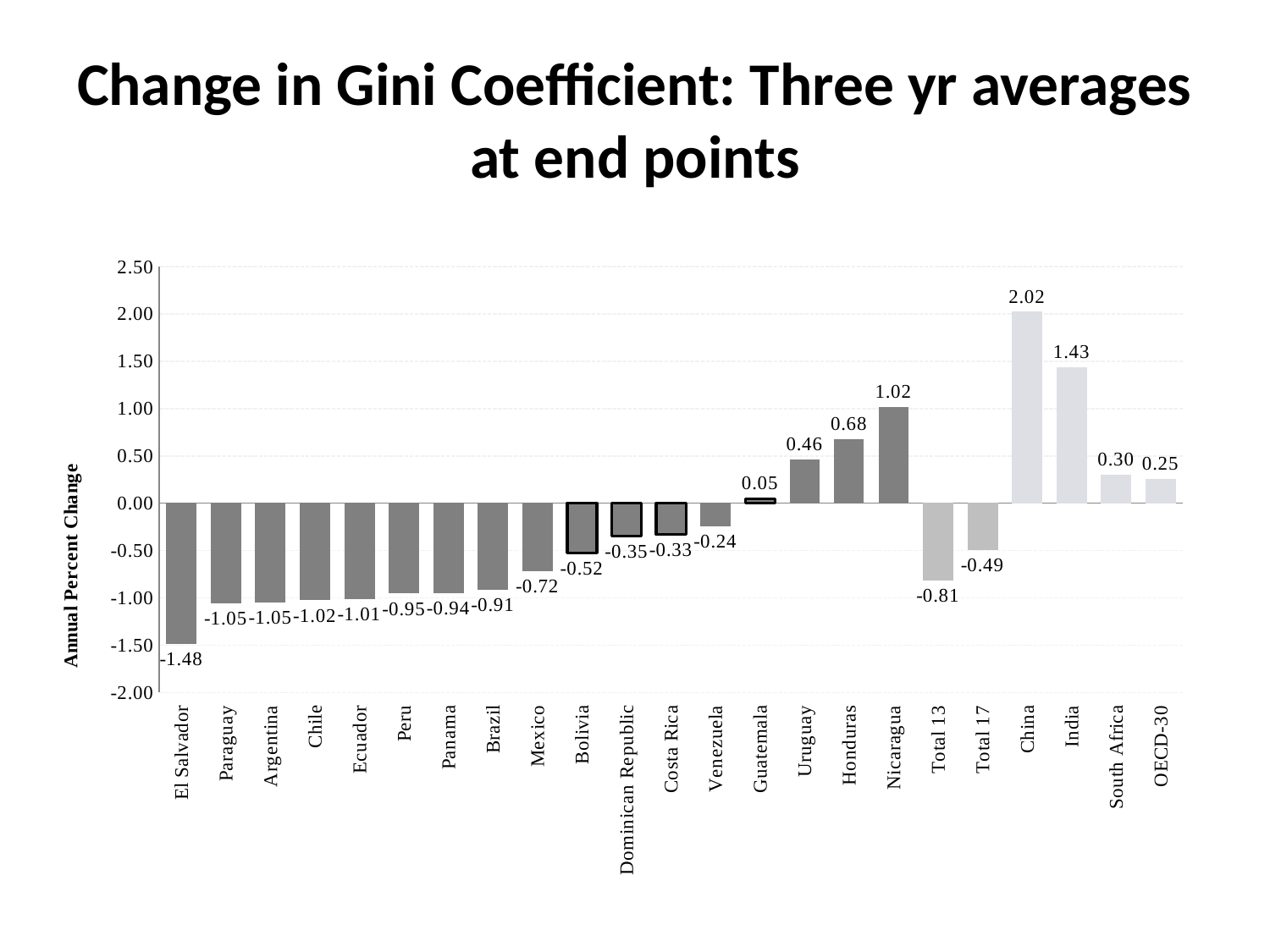
What is the value for Total 17? -0.49 What is the label on the vertical axis? Annual Percent Change Which category has the lowest value? El Salvador What is the value for El Salvador? -1.48 What is the value for OECD-30? 0.25 How many categories are shown on the x axis? 23 What is the difference between the values for China and India? 0.59 What kind of chart is this? bar chart Is the value for Mexico greater or less than -0.50? less Which category has the highest value? China What is the value for Nicaragua? 1.02 Which is larger, the value for Honduras or the value for Uruguay? Honduras